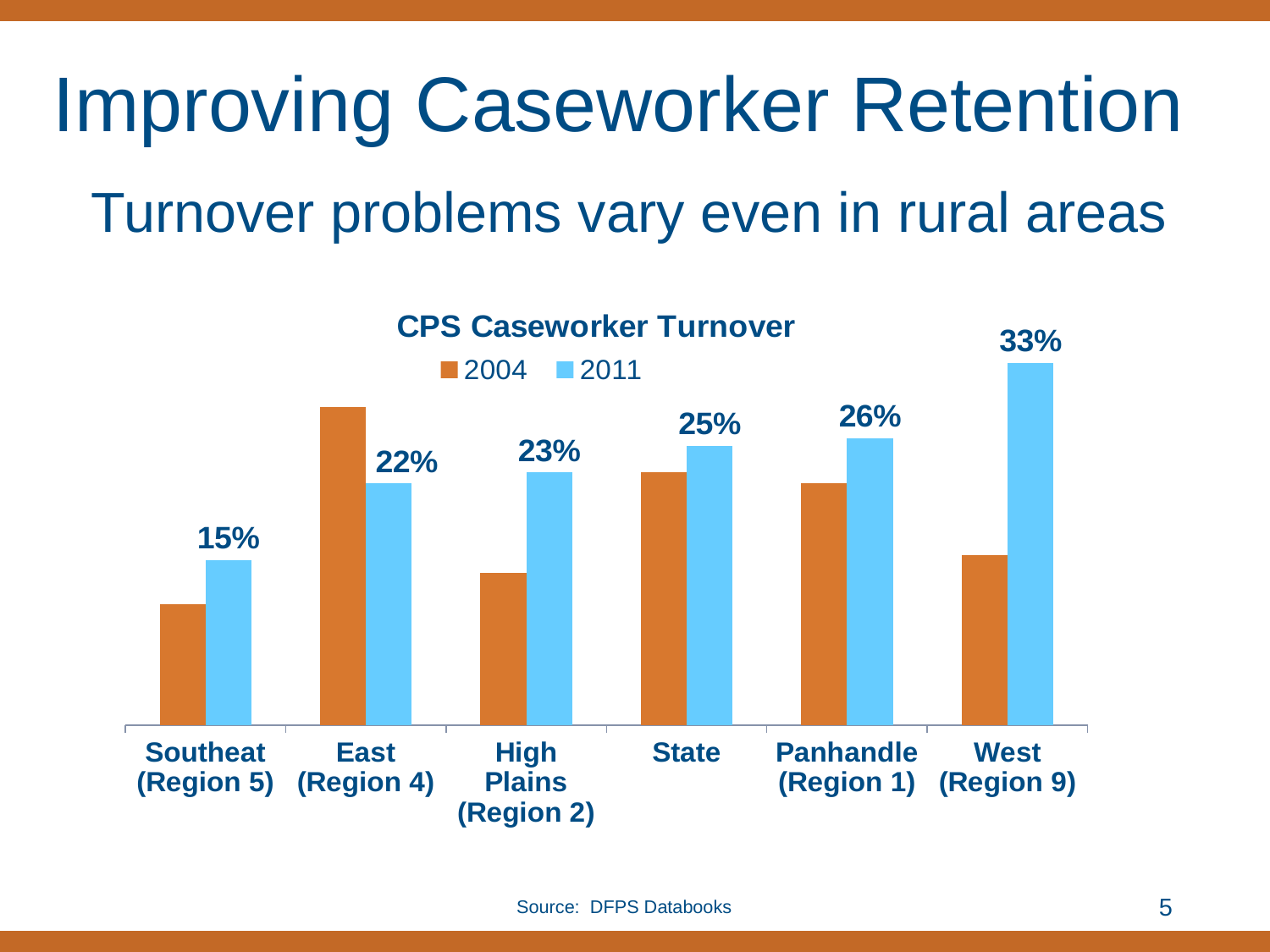
What kind of chart is shown on the slide? Bar chart What is the 2011 turnover value for the State? 25% What is the 2011 turnover value for Southeast (Region 5)? 15% What is the difference between the 2011 turnover for West (Region 9) and Southeast (Region 5)? 18% For West (Region 9), which year has the higher turnover, 2004 or 2011? 2011 What is the 2011 CPS caseworker turnover value for West (Region 9)? 33% What is the 2011 turnover value for High Plains (Region 2)? 23% How many categories are shown on the x axis of the chart? 6 Which region has the highest 2011 turnover? West (Region 9) For East (Region 4), which year has the higher turnover, 2004 or 2011? 2004 How many series does the legend list? 2 Which region has the lowest 2011 turnover? Southeast (Region 5)